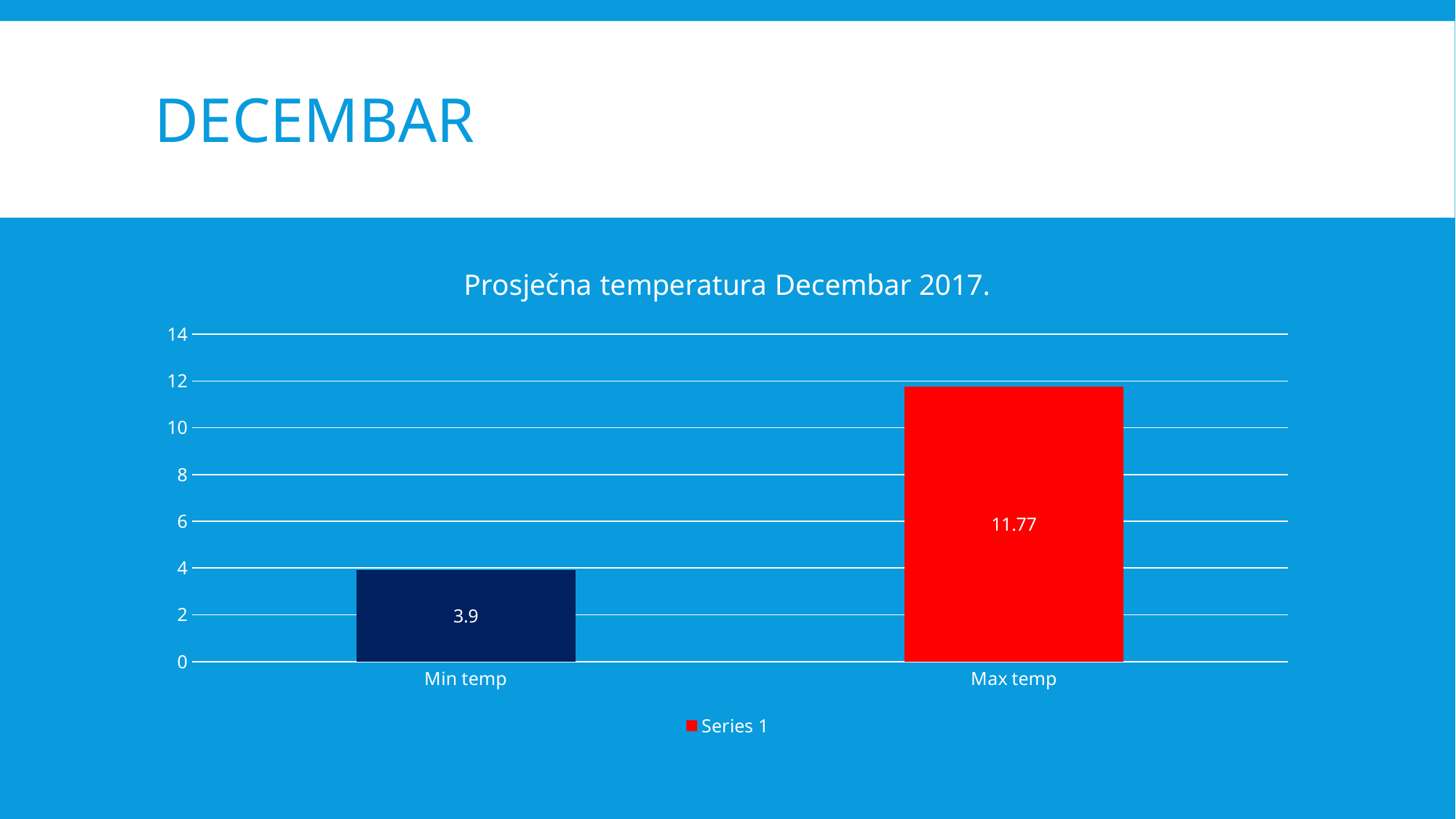
How many categories are shown on the x axis? 2 What is the value for Min temp? 3.9 What is the value for Max temp? 11.77 Which category has the highest value? Max temp What is the difference between the Max temp and Min temp values? 7.87 Which category has the lowest value? Min temp What kind of chart is shown on the slide? bar chart Is the value for Max temp greater or less than 10? greater Which is larger, the value for Min temp or the value for Max temp? Max temp Is the value for Min temp greater or less than 4? less How many series does the legend list? 1 What is the title of the chart? Prosječna temperatura Decembar 2017.